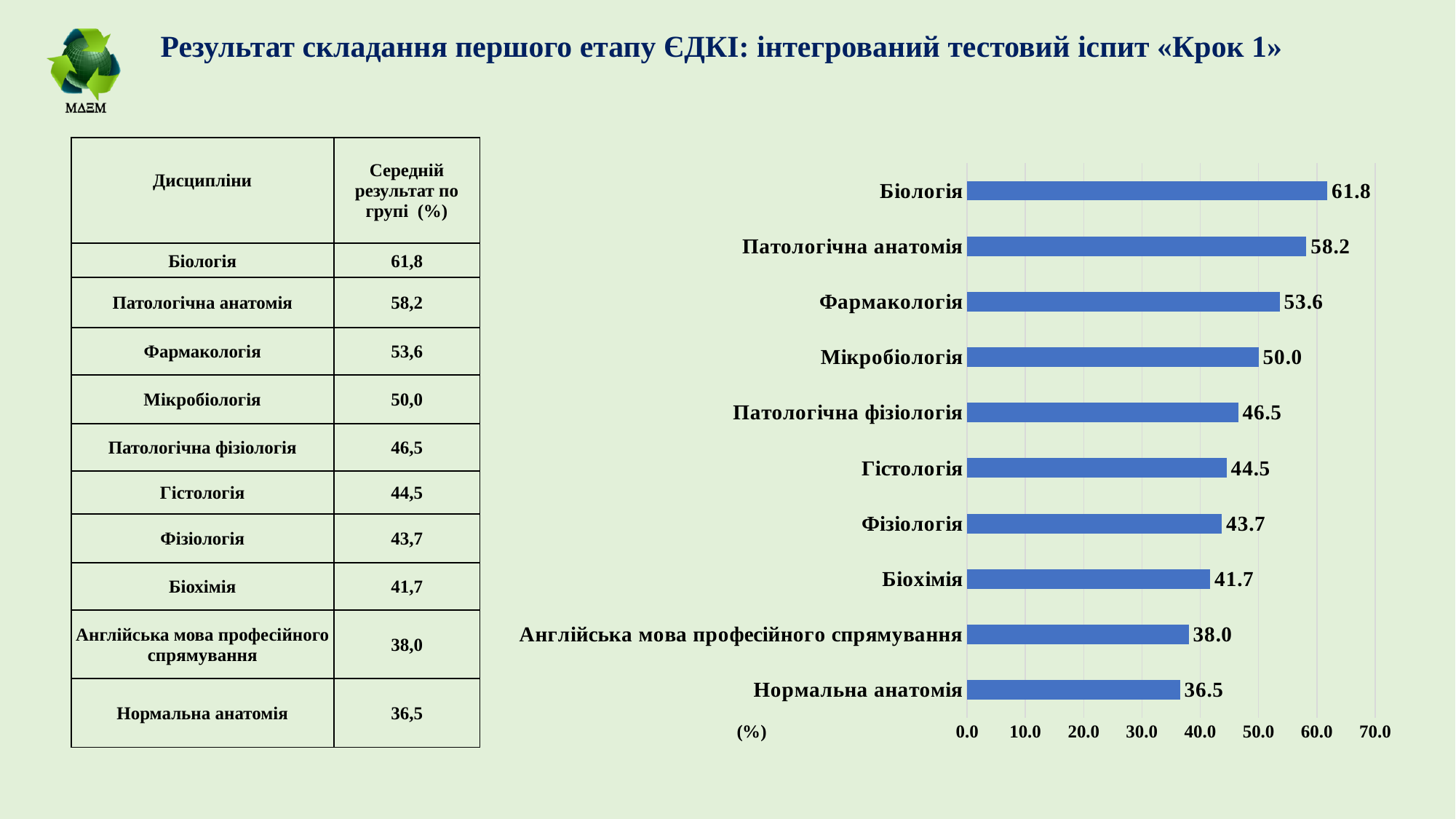
Which category has the lowest value in the bar chart? Нормальна анатомія Is the value for Гістологія in the bar chart greater or less than 50.0? less How many categories are shown in the bar chart? 10 Which has a larger value in the bar chart, Патологічна анатомія or Фармакологія? Патологічна анатомія What is the difference between the values for Біологія and Нормальна анатомія in the bar chart? 25.3 What is the difference between the values for Фармакологія and Мікробіологія in the bar chart? 3.6 What kind of chart is shown on the slide? bar chart What is the value for Біологія in the bar chart? 61.8 What is the value for Англійська мова професійного спрямування in the bar chart? 38.0 Which category has the highest value in the bar chart? Біологія What unit is indicated on the horizontal axis of the bar chart? (%) What is the value for Мікробіологія in the bar chart? 50.0